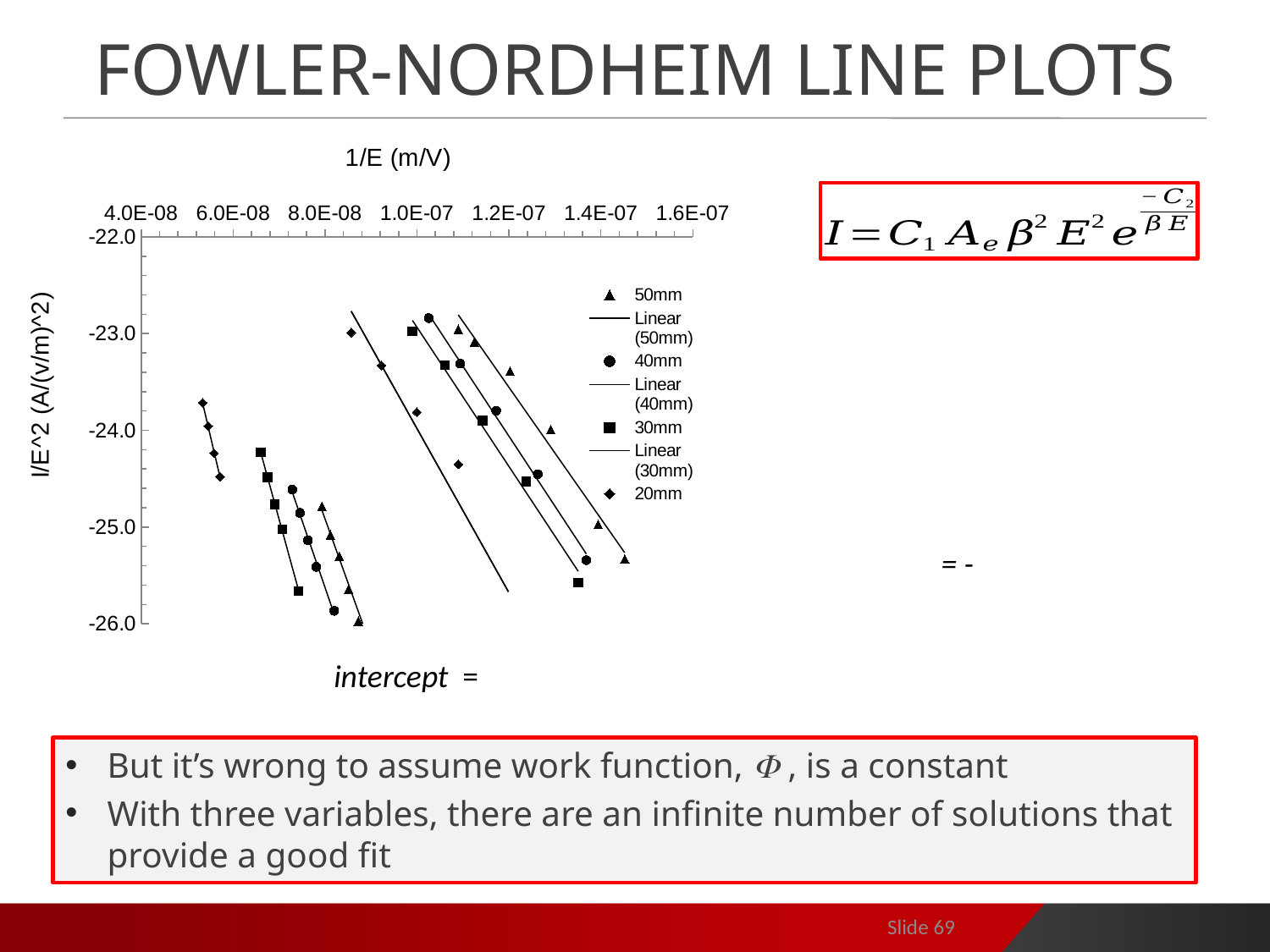
What kind of chart is shown on the slide? scatter chart Are the y values of the 20mm series greater or less than -25.0? greater How many entries does the chart legend list? 7 What is the highest tick value shown on the x axis? 1.6E-07 Which series in the legend has no linear trendline listed? 20mm How many data series (marker series) are plotted in the chart, excluding the linear trendlines? 4 Is the lowest y value of the 50mm series greater or less than -25.0? less Do the plotted values rise or fall as 1/E increases along the x axis? fall How many linear trendlines does the legend list? 3 What is the lowest tick value shown on the y axis? -26.0 What is the title of the x axis of the chart? 1/E (m/V) What is the title of the y axis of the chart? I/E^2 (A/(v/m)^2)